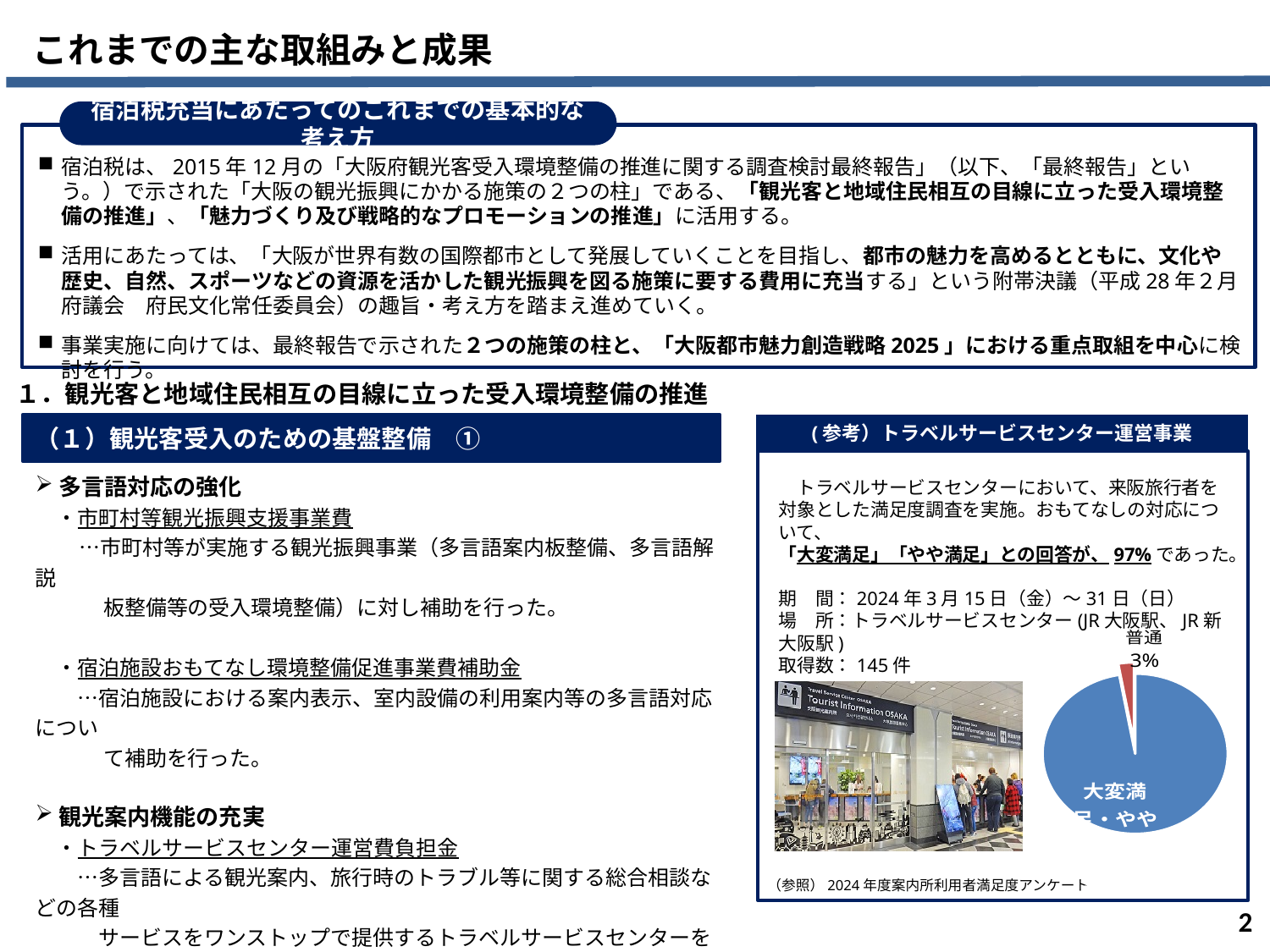
Which slice of the pie chart is the largest? 大変満足・やや満足 What is the difference in percentage points between the 大変満足・やや満足 share and the 普通 share? 94 According to the slide, what share of responses were 大変満足 or やや満足? 97% What share of the pie does the 普通 slice represent? 3% What survey is cited as the source of the pie chart? 2024年度案内所利用者満足度アンケート What kind of chart is shown in the (参考) トラベルサービスセンター運営事業 box? Pie chart What colour is the 普通 slice in the pie chart? Red What percentage is shown for the 普通 slice of the pie chart? 3% Which slice of the pie chart is the smallest? 普通 How many slices does the pie chart have? 2 In the pie chart, which is larger: 普通 or 大変満足・やや満足? 大変満足・やや満足